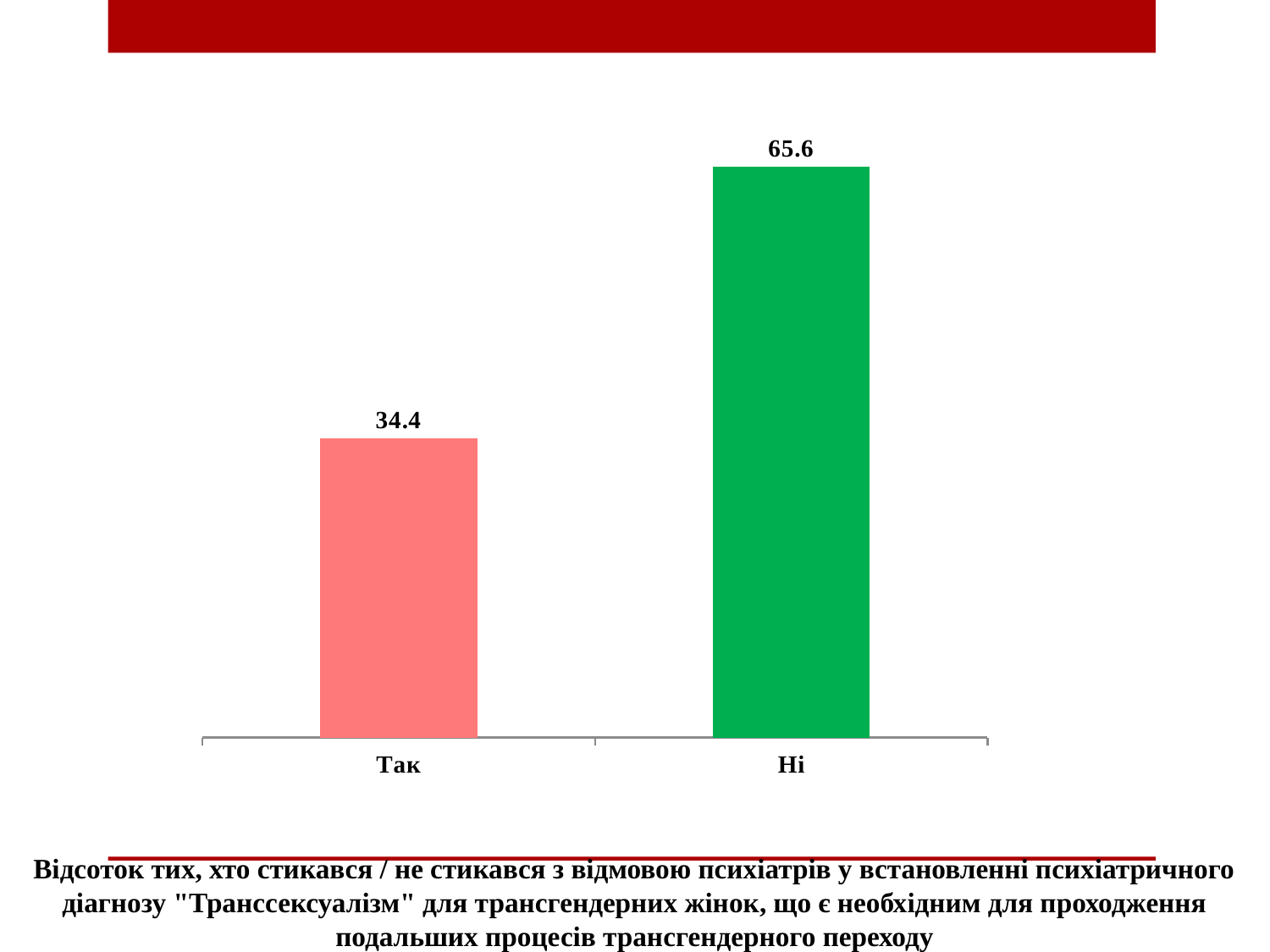
What is the value for "Так"? 34.4 Which category has the highest value? Ні What kind of chart is shown on the slide? bar chart What is the difference between the values for "Ні" and "Так"? 31.2 What colour is the bar for "Так"? pink Which is larger, the value for "Так" or the value for "Ні"? Ні Which category has the lowest value? Так What is the value for "Ні"? 65.6 What is the total of the two values shown on the chart? 100 How many categories are shown on the chart? 2 What colour is the bar for "Ні"? green